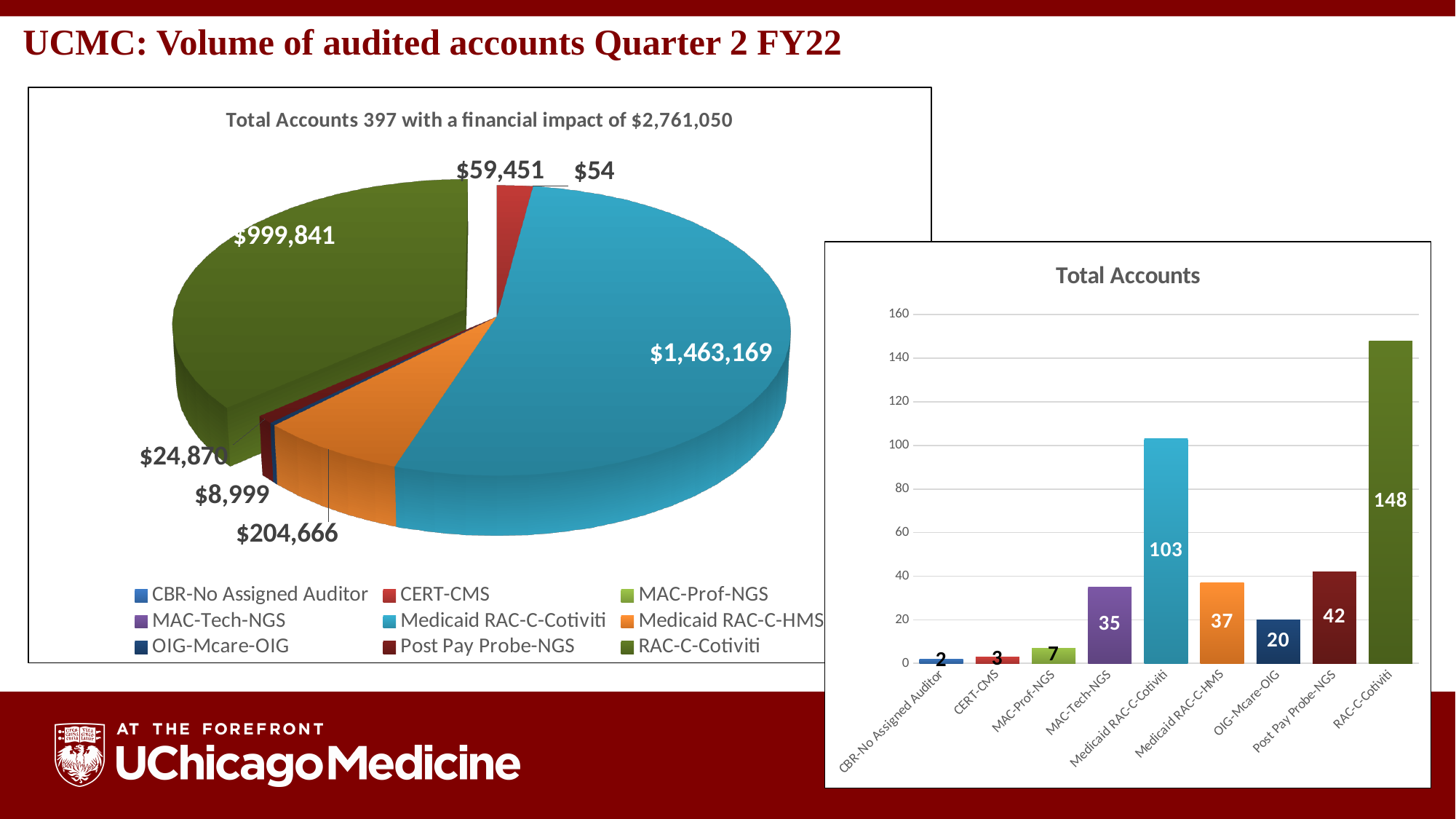
What kind of chart is the chart on the left of the slide? pie chart How many categories are shown in the 'Total Accounts' bar chart? 9 In the 'Total Accounts' bar chart, what is the value for Post Pay Probe-NGS? 42 In the 'Total Accounts' bar chart, which category has the lowest value? CBR-No Assigned Auditor In the pie chart on the left, what is the financial impact value for Medicaid RAC-C-Cotiviti? $1,463,169 In the 'Total Accounts' bar chart, is the value for RAC-C-Cotiviti greater or less than 140? greater In the 'Total Accounts' bar chart, which is larger: Medicaid RAC-C-HMS or MAC-Tech-NGS? Medicaid RAC-C-HMS In the 'Total Accounts' bar chart, what is the value for Medicaid RAC-C-Cotiviti? 103 What kind of chart is the 'Total Accounts' chart on the right of the slide? bar chart In the 'Total Accounts' bar chart, which category has the highest value? RAC-C-Cotiviti In the 'Total Accounts' bar chart, what is the difference between the values for RAC-C-Cotiviti and Medicaid RAC-C-Cotiviti? 45 In the pie chart on the left, what is the financial impact value for RAC-C-Cotiviti? $999,841